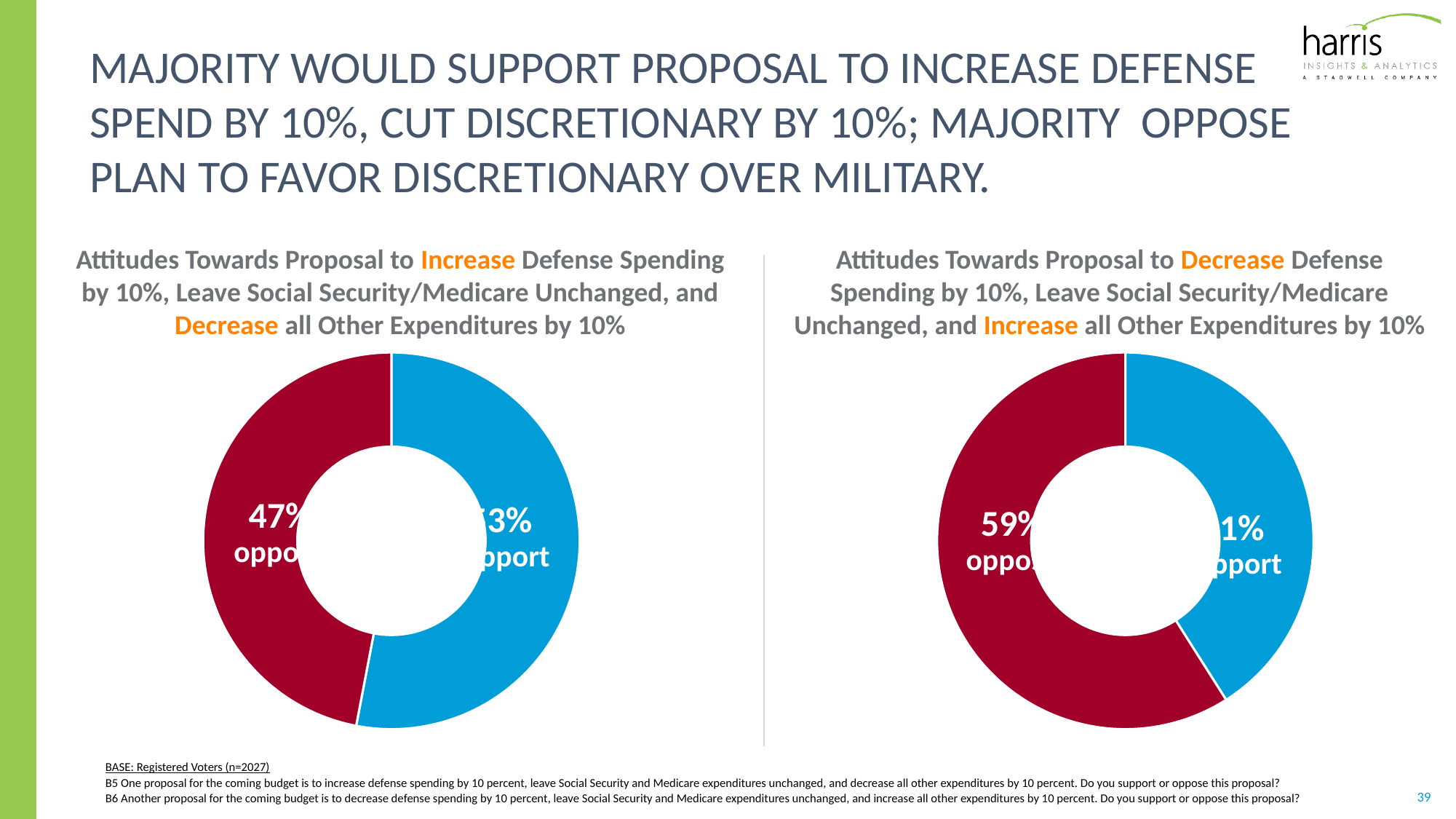
In the right chart (Decrease Defense Spending proposal), which is larger: the share that supports or the share that opposes? Oppose How many donut charts are shown on the slide? 2 In the left chart (Increase Defense Spending proposal), which is larger: the share that supports or the share that opposes? Support In the right chart (Decrease Defense Spending proposal), which slice is the largest? Oppose (59%) In the left chart (Increase Defense Spending proposal), is the oppose share greater or less than 50%? less In the right chart (Decrease Defense Spending proposal), is the oppose share greater or less than 50%? greater What kind of chart is used on the left side of the slide? Donut (pie) chart In the left chart (Attitudes Towards Proposal to Increase Defense Spending by 10%), what percentage oppose the proposal? 47% What colour is used for the 'oppose' slice in both donut charts? Dark red What is the difference between the oppose percentage in the right chart and the oppose percentage in the left chart? 12 percentage points How many slices does the left donut chart have? 2 In the right chart (Attitudes Towards Proposal to Decrease Defense Spending by 10%), what percentage oppose the proposal? 59%